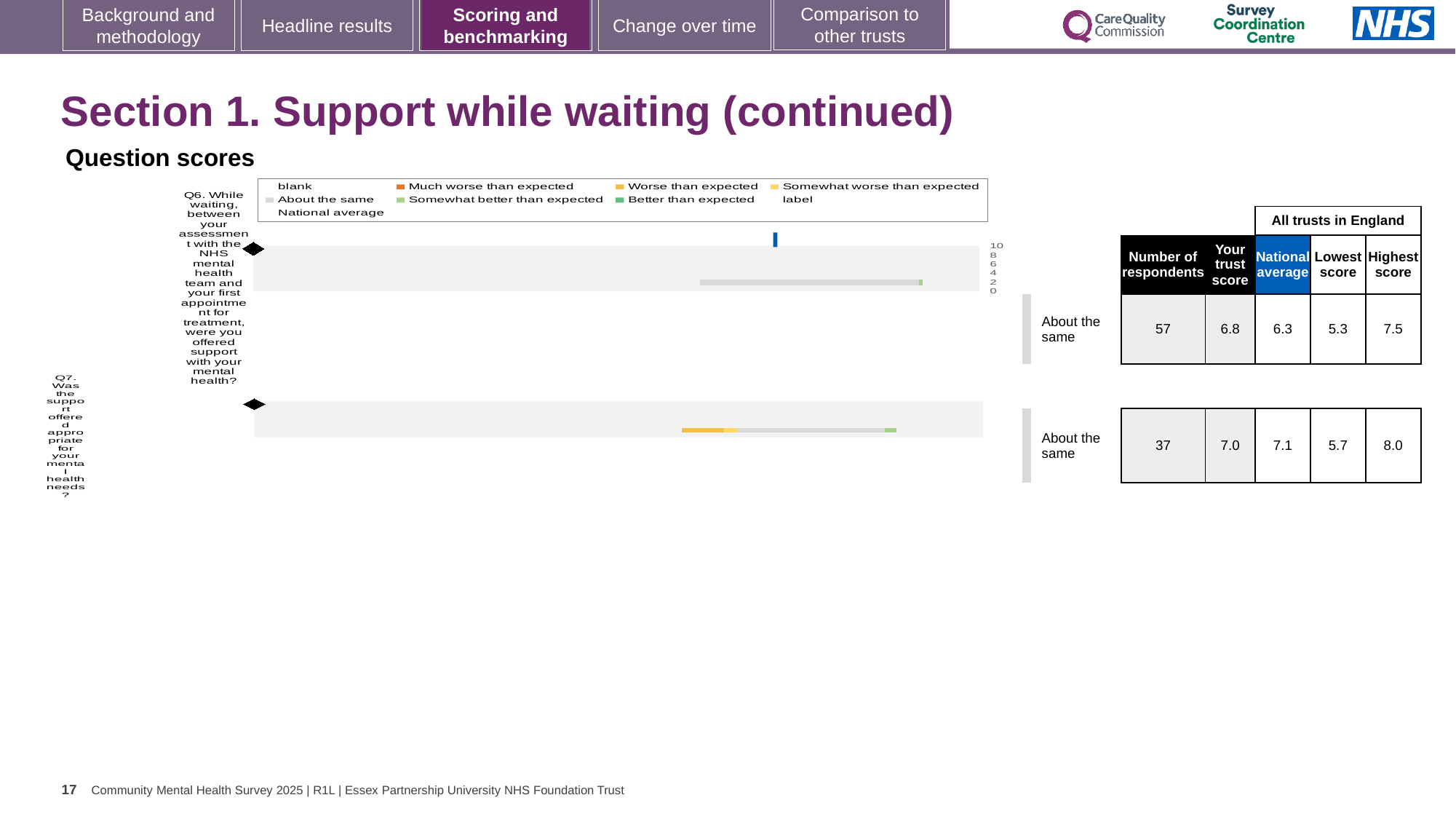
Which question had more respondents, Q6 or Q7? Q6 For Q6, which is larger: the trust score or the national average? the trust score What is the difference between the highest score and the lowest score for Q7? 2.3 How many legend entries contain the phrase 'than expected'? 5 How many respondents answered Q6? 57 What benchmark category is shown for Q7? About the same How many questions (bars) are plotted in the chart? 2 What is the maximum value shown on the chart's score axis? 10 What is the 'Your trust score' for Q6? 6.8 What is the national average for Q7? 7.1 What is the difference between the highest score and the lowest score for Q6? 2.2 What kind of chart is shown under 'Question scores'? bar chart